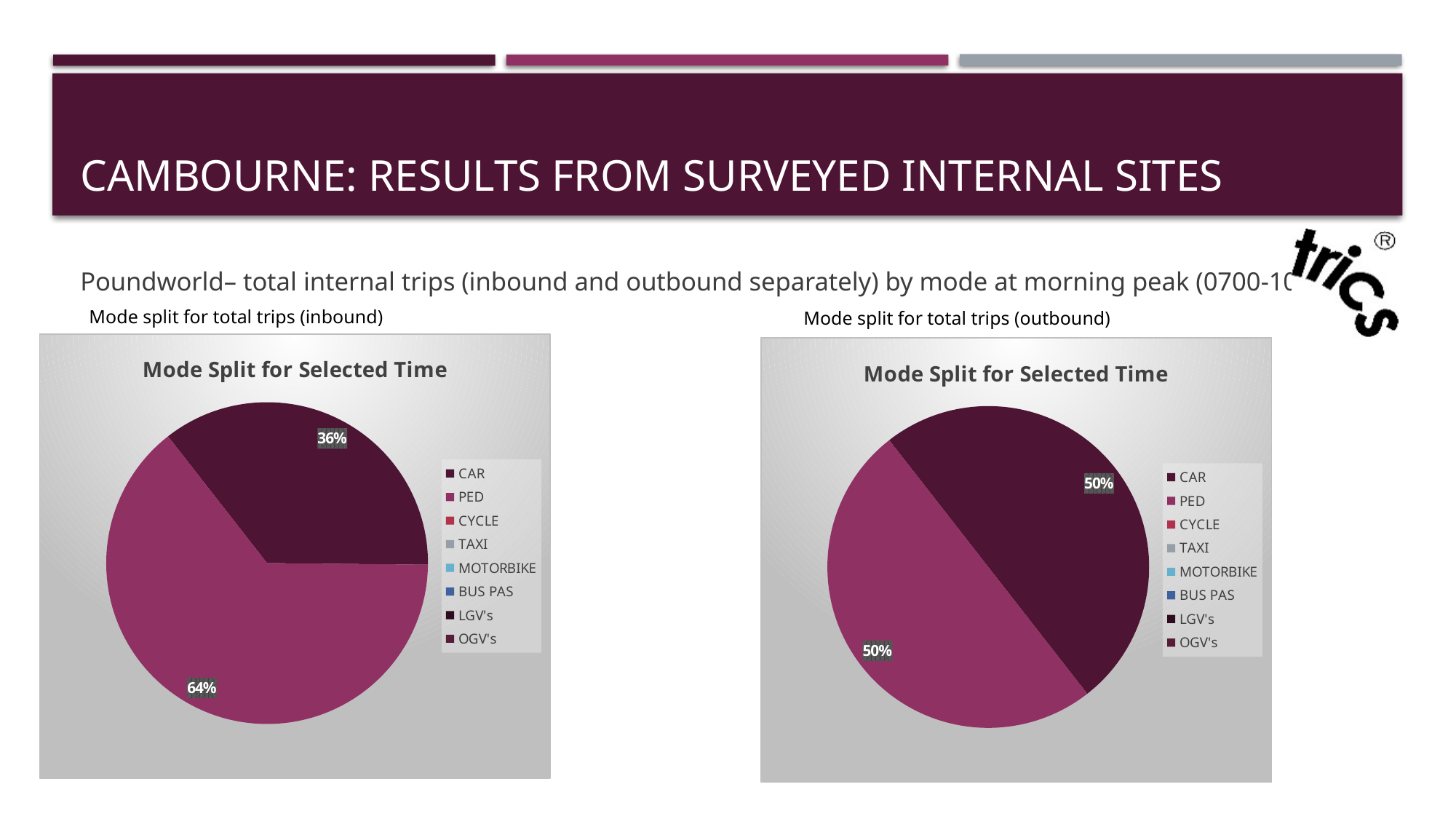
In the inbound mode split pie chart, which mode has the largest share? PED In the outbound mode split pie chart, what share of trips is by PED? 50% In the inbound mode split pie chart, what share of trips is by CAR? 36% What type of chart is used for the outbound mode split? Pie chart In the outbound mode split pie chart, what share of trips is by CAR? 50% In the inbound mode split pie chart, is the PED share larger or smaller than the CAR share? larger How many slices are visible in the outbound mode split pie chart? 2 How many modes does the legend of the inbound mode split chart list? 8 In the inbound mode split pie chart, which of the two shown modes has the smaller share? CAR What is the title shown inside the inbound chart? Mode Split for Selected Time In the inbound mode split pie chart, what is the difference in percentage points between the PED share and the CAR share? 28